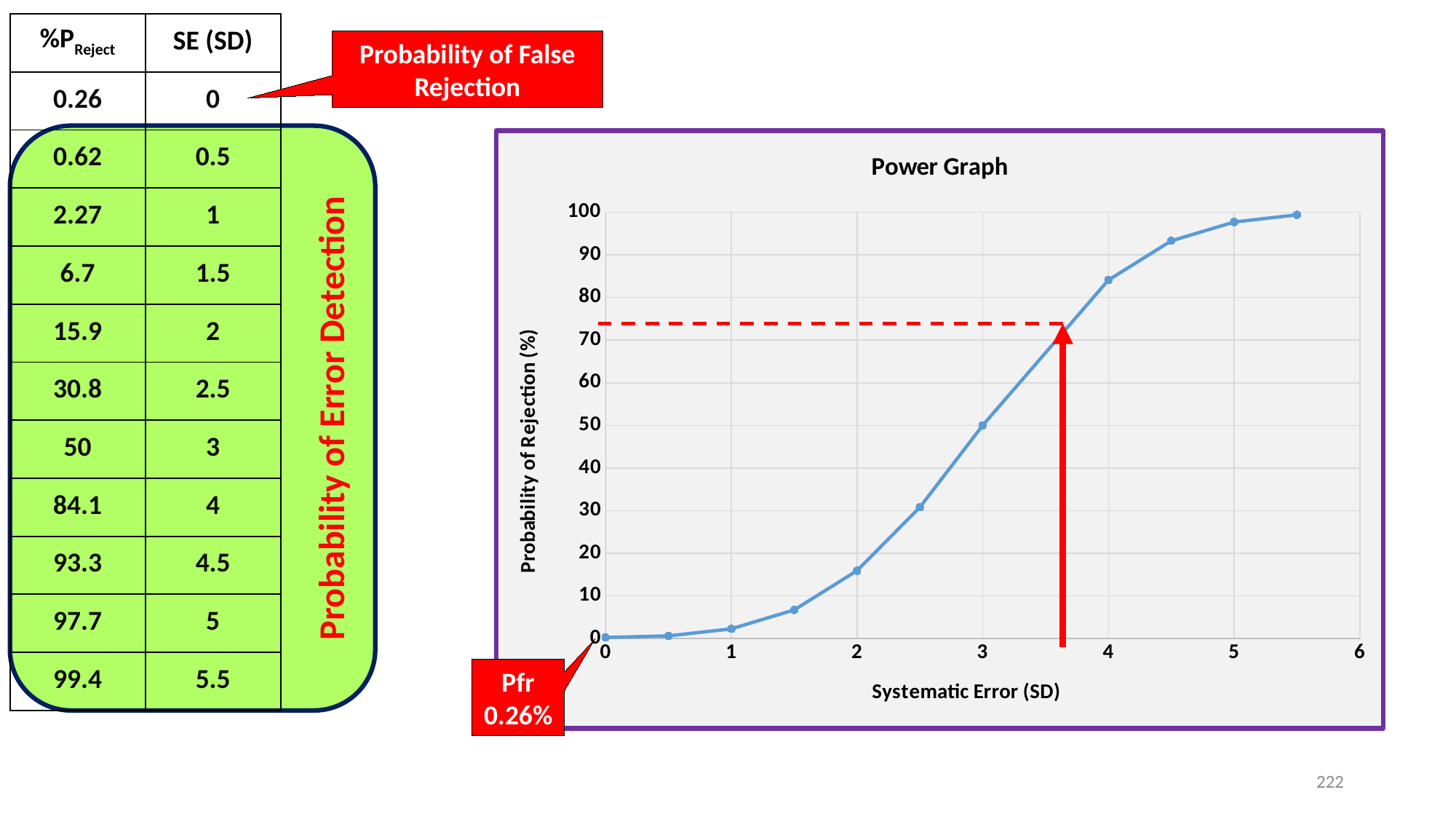
In the Power Graph, at which systematic error is the probability of rejection lowest? 0 SD In the Power Graph, at which systematic error is the probability of rejection highest? 5.5 SD What kind of chart is the Power Graph? line chart In the Power Graph, which has the higher probability of rejection: a systematic error of 2.5 SD or 4.5 SD? 4.5 SD In the Power Graph, what is the probability of rejection at a systematic error of 3 SD? 50 In the Power Graph, does the probability of rejection rise or fall as systematic error increases? rises What is the label of the y axis of the Power Graph? Probability of Rejection (%) What is the title of the chart? Power Graph In the Power Graph, is the probability of rejection at a systematic error of 5 SD greater or less than 90? greater How many data points are plotted on the Power Graph line? 11 In the Power Graph, is the probability of rejection at a systematic error of 4 SD greater or less than 80? greater In the Power Graph, is the probability of rejection at a systematic error of 2 SD greater or less than 20? less